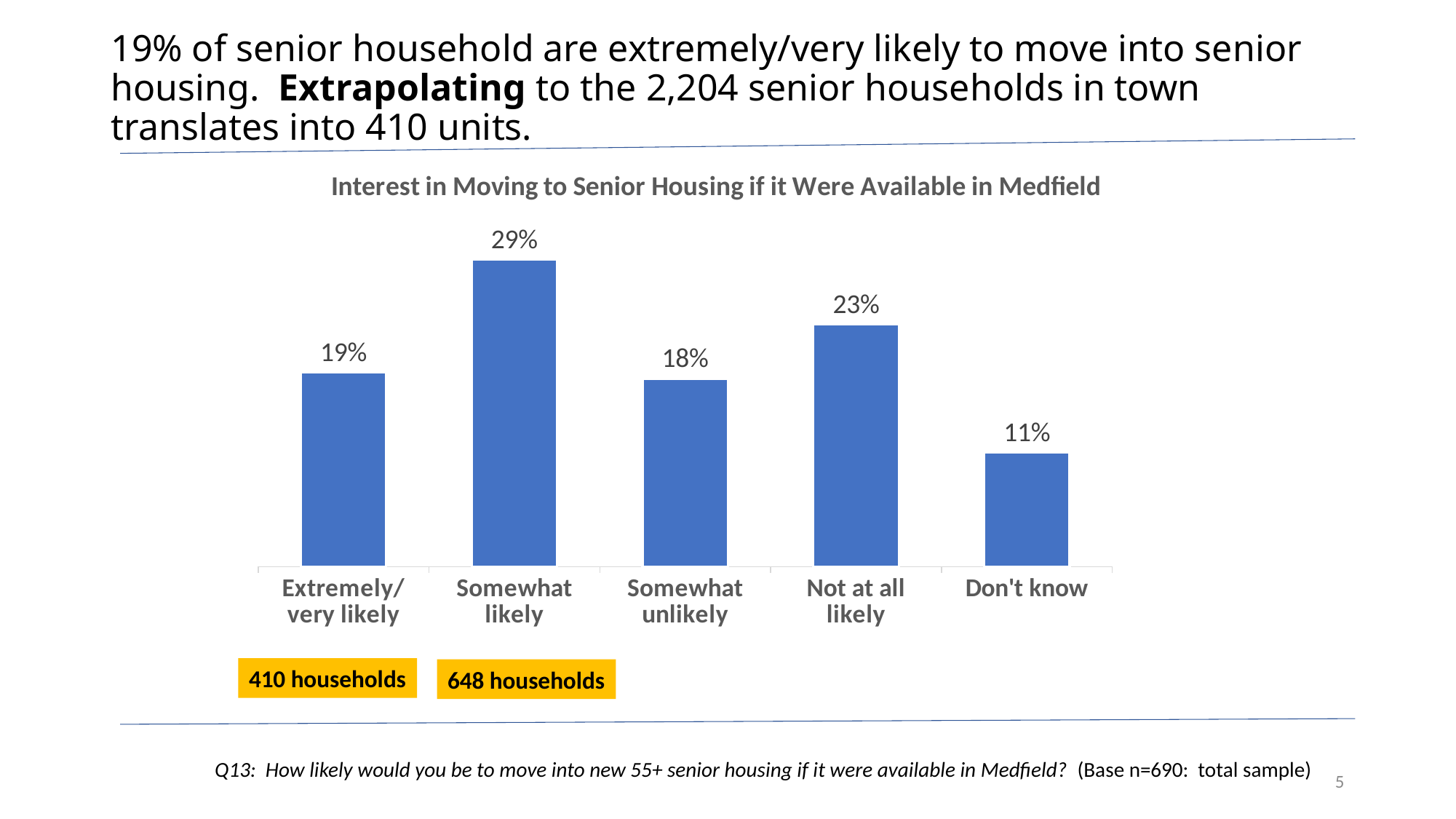
Which category has the lowest value? Don't know What kind of chart is shown on the slide? Bar chart What is the combined value of the Extremely/very likely and Somewhat likely categories? 48% What is the difference between the Somewhat likely and Extremely/very likely values? 10% What is the value for Not at all likely? 23% Which is larger, the value for Not at all likely or the value for Somewhat unlikely? Not at all likely What is the title of the chart? Interest in Moving to Senior Housing if it Were Available in Medfield Which category has the highest value? Somewhat likely What percentage of respondents are Somewhat likely to move into senior housing? 29% What is the difference between the Extremely/very likely and Somewhat unlikely values? 1% How many categories are shown on the x axis? 5 What is the value for the Don't know category? 11%